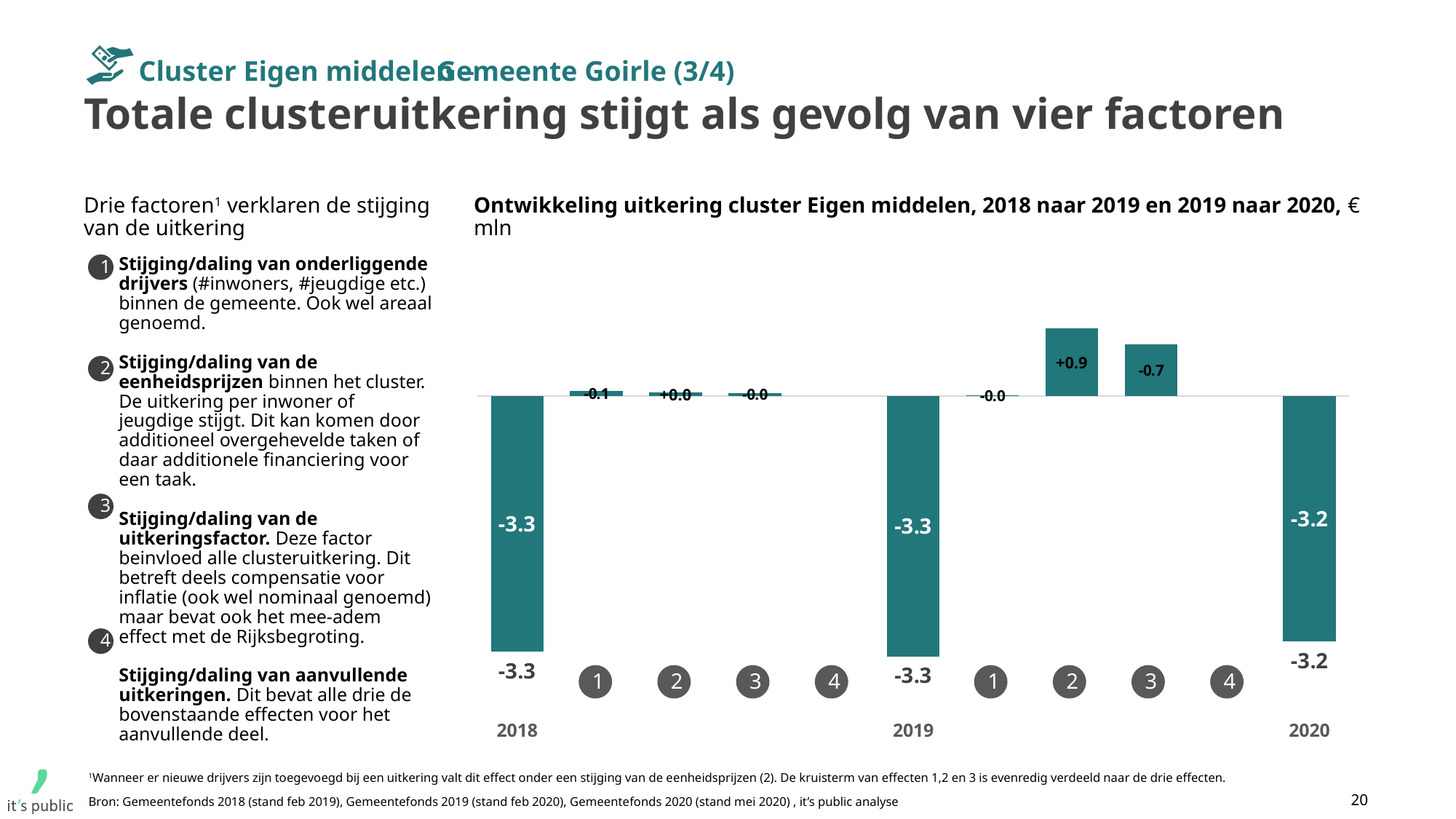
What is the value shown for 2018 in the chart? -3.3 What is the difference between the factor 2 value (+0.9) and the factor 3 value (-0.7) in the change from 2019 to 2020? 1.6 Which factor in the change from 2019 to 2020 has the largest positive value? Factor 2 In what unit are the values in the chart expressed, according to the chart title? € mln Is the value for 2020 larger or smaller than the value for 2018? larger How many years are labelled on the x axis of the chart? 3 What is the value shown for 2020 in the chart? -3.2 What is the value of factor 2 in the change from 2019 to 2020? +0.9 What is the value of factor 1 in the change from 2018 to 2019? -0.1 What kind of chart is shown on the slide? Bar chart (waterfall) What is the value of factor 3 in the change from 2019 to 2020? -0.7 What is the value shown for 2019 in the chart? -3.3